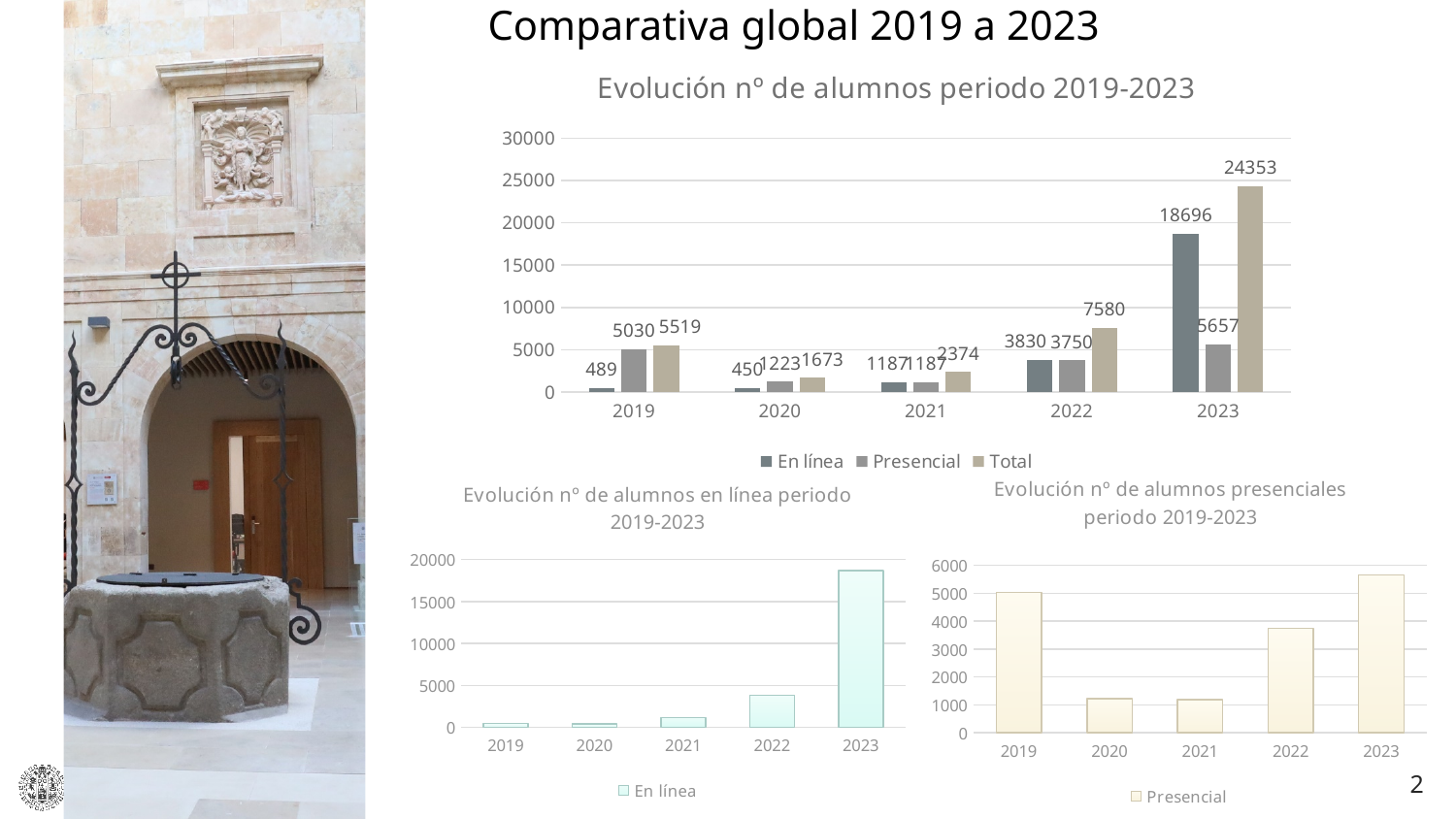
In the chart 'Evolución nº de alumnos en línea periodo 2019-2023', is the value for 2023 greater or less than 15000? greater In the chart 'Evolución nº de alumnos periodo 2019-2023', what is the Presencial value for 2022? 3750 In the chart 'Evolución nº de alumnos periodo 2019-2023', which year has the highest En línea value? 2023 In the chart 'Evolución nº de alumnos periodo 2019-2023', what is the Total value for 2023? 24353 How many years are shown on the x axis of the chart 'Evolución nº de alumnos en línea periodo 2019-2023'? 5 What kind of chart is 'Evolución nº de alumnos presenciales periodo 2019-2023'? bar chart In the chart 'Evolución nº de alumnos periodo 2019-2023', what is the difference between the En línea and Presencial values for 2023? 13039 How many series does the legend of the chart 'Evolución nº de alumnos periodo 2019-2023' list? 3 In the chart 'Evolución nº de alumnos presenciales periodo 2019-2023', is the value for 2020 greater or less than 2000? less In the chart 'Evolución nº de alumnos periodo 2019-2023', which year has the lowest Total value? 2020 In the chart 'Evolución nº de alumnos periodo 2019-2023', which is larger in 2019, En línea or Presencial? Presencial In the chart 'Evolución nº de alumnos periodo 2019-2023', what is the En línea value for 2019? 489